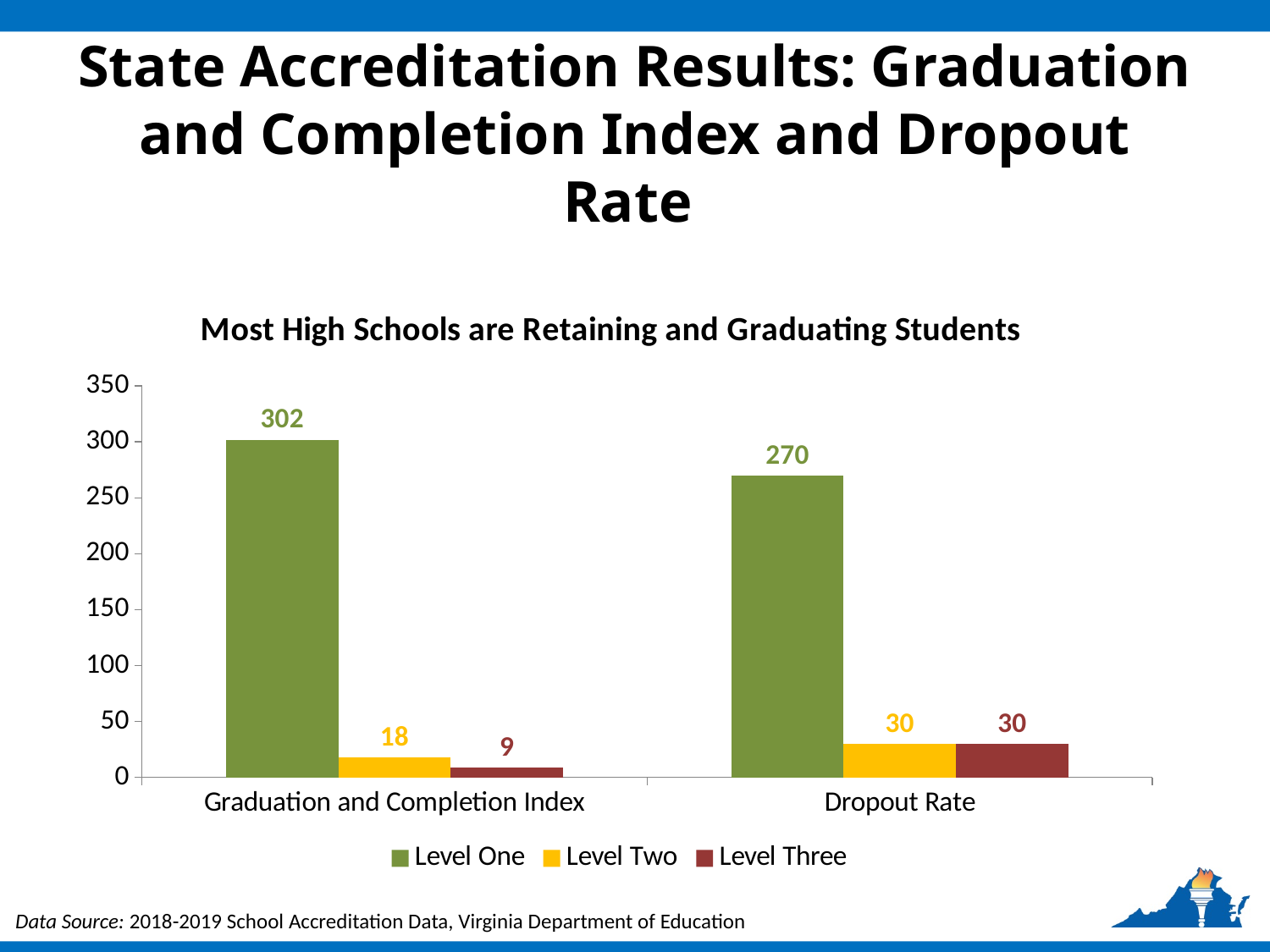
Which series has the lowest value for Graduation and Completion Index? Level Three What is the Level Two value for Dropout Rate? 30 What is the title of the chart? Most High Schools are Retaining and Graduating Students What is the Level Three value for Graduation and Completion Index? 9 Is the Level One value for Dropout Rate greater or less than 250? greater Which category has the highest Level One value? Graduation and Completion Index What is the difference between the Level One values for Graduation and Completion Index and Dropout Rate? 32 How many series does the legend list? 3 What is the Level One value for Graduation and Completion Index? 302 Is the Level Two value larger for Graduation and Completion Index or for Dropout Rate? Dropout Rate What kind of chart is shown on the slide? bar chart How many categories are shown on the x axis? 2